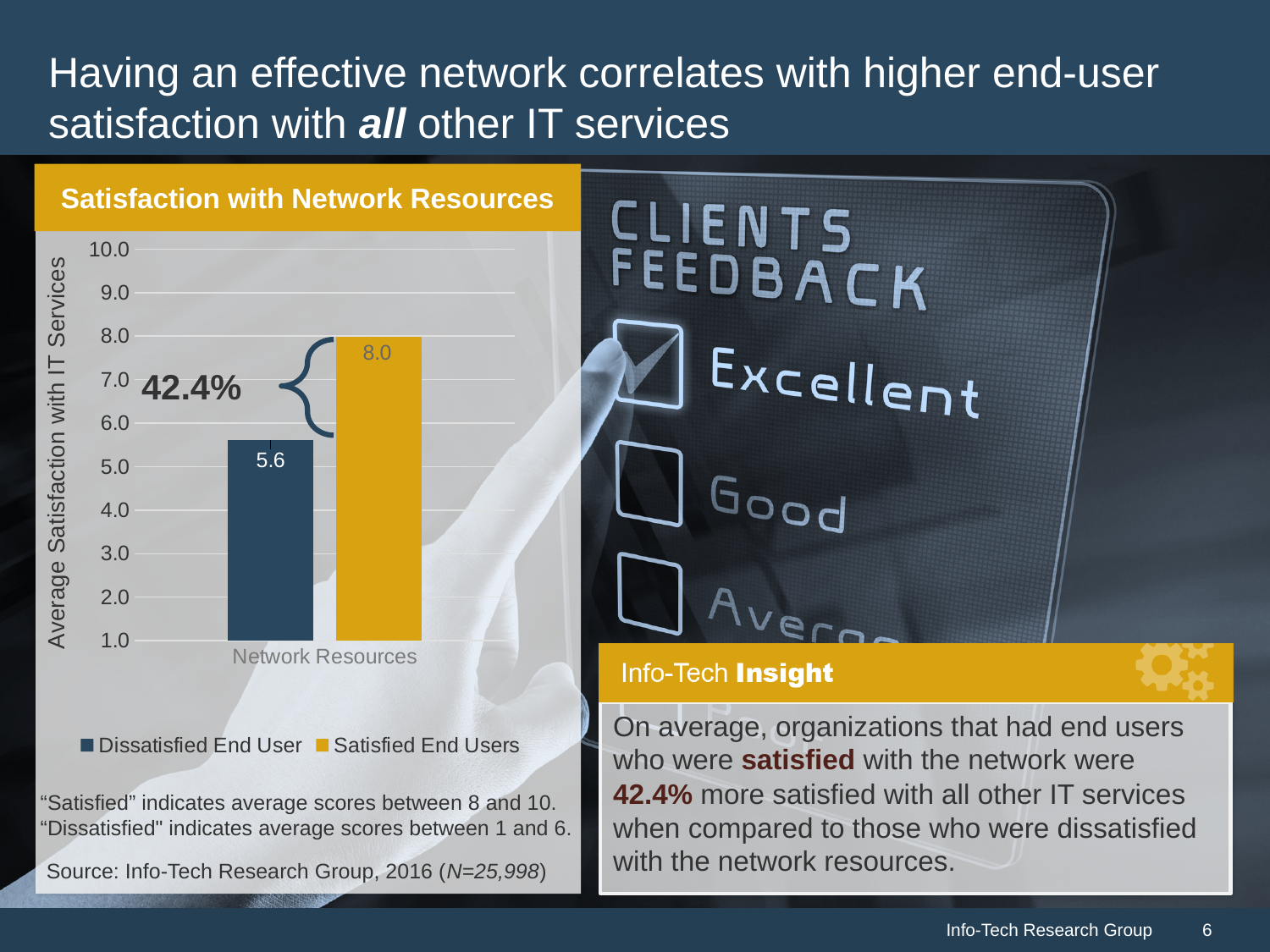
How many series does the chart legend list? 2 What is the label on the vertical axis of the chart? Average Satisfaction with IT Services What is the value for Satisfied End Users in the Satisfaction with Network Resources chart? 8.0 What is the title of the chart on the slide? Satisfaction with Network Resources Which series has the higher value in the Satisfaction with Network Resources chart? Satisfied End Users What is the difference between the Satisfied End Users and Dissatisfied End User values in the chart? 2.4 What category label appears on the x axis of the chart? Network Resources What kind of chart is shown on the slide? Bar chart What is the value for Dissatisfied End User in the Satisfaction with Network Resources chart? 5.6 Is the value for Satisfied End Users greater or less than 7.0? greater Which series has the lower value in the Satisfaction with Network Resources chart? Dissatisfied End User Is the value for Dissatisfied End User greater or less than 6.0? less